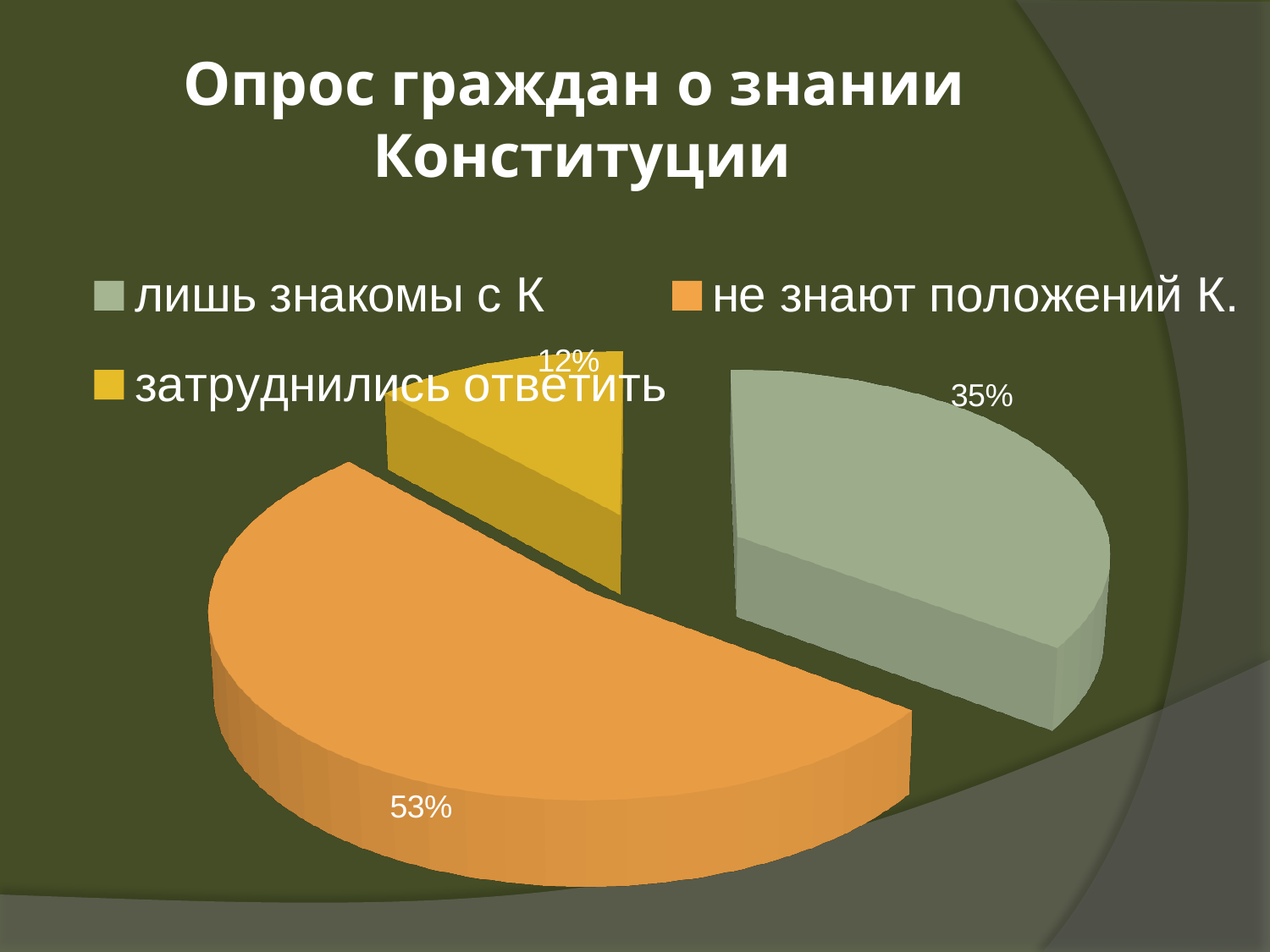
What share of the pie does "не знают положений К." take? 53% Which category has the smallest slice of the pie? затруднились ответить What is the difference between the shares for "не знают положений К." and "лишь знакомы с К"? 18% Which category has the largest slice of the pie? не знают положений К. Which is larger: the share for "лишь знакомы с К" or the share for "затруднились ответить"? лишь знакомы с К What share of the pie does "затруднились ответить" take? 12% How many categories does the pie chart show? 3 What is the title of the chart? Опрос граждан о знании Конституции What kind of chart is shown on the slide? pie chart What is the difference between the shares for "лишь знакомы с К" and "затруднились ответить"? 23% What share of the pie does "лишь знакомы с К" take? 35% Which colour represents "затруднились ответить" in the legend? yellow